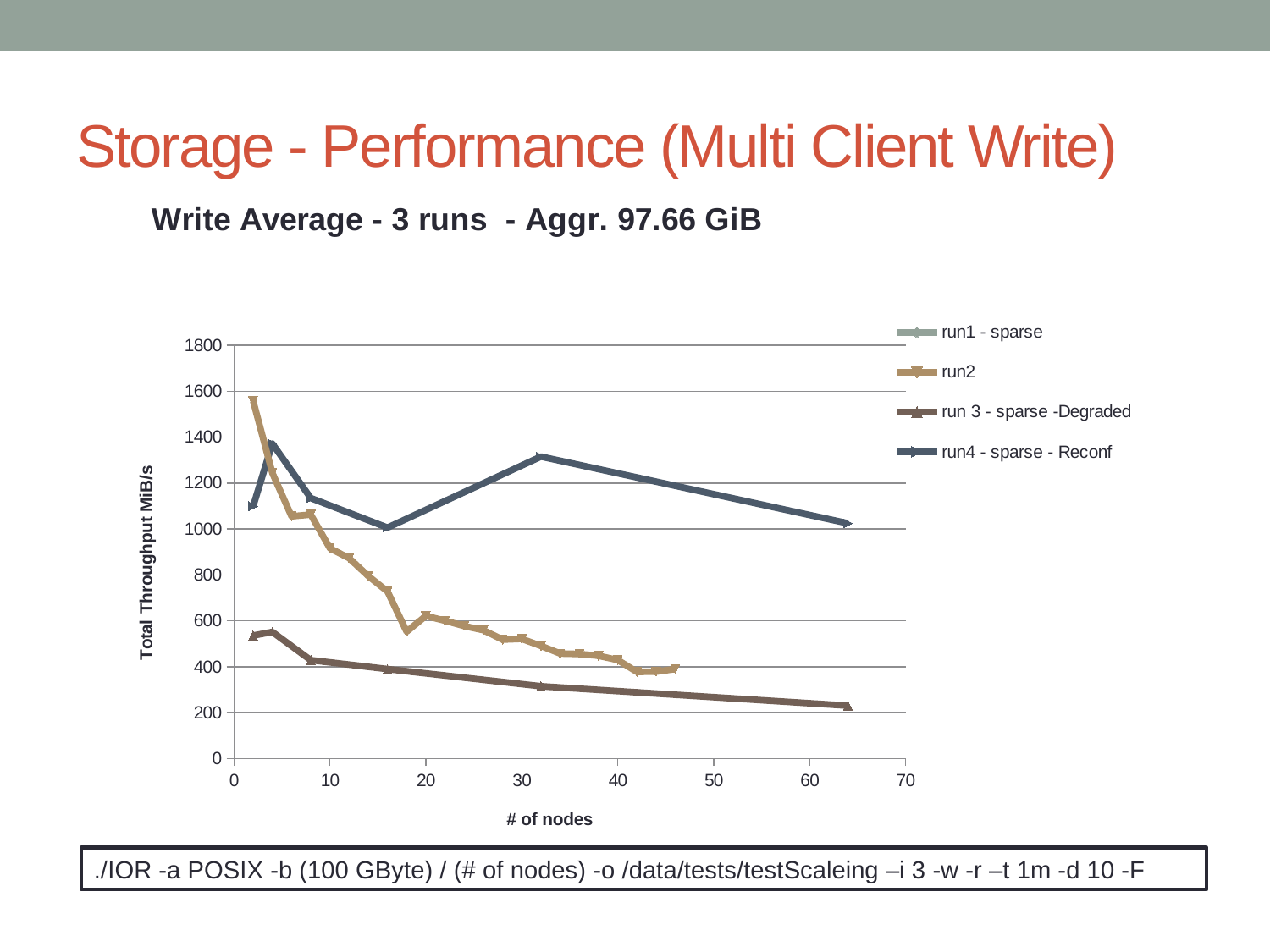
Is the value for run4 - sparse - Reconf at 32 nodes greater or less than 1200? greater Is the value for run2 at 2 nodes greater or less than 1400? greater At 32 nodes, which series has the larger value: run4 - sparse - Reconf or run2? run4 - sparse - Reconf How many series does the chart legend list? 4 Do the values for run 3 - sparse -Degraded generally rise or fall as the number of nodes increases? fall What kind of chart is shown on the slide? line chart Is the value for run 3 - sparse -Degraded at 64 nodes greater or less than 400? less What is the title of the chart's horizontal axis? # of nodes What is the title of the chart's vertical axis? Total Throughput MiB/s At 20 nodes, which series has the larger value: run2 or run 3 - sparse -Degraded? run2